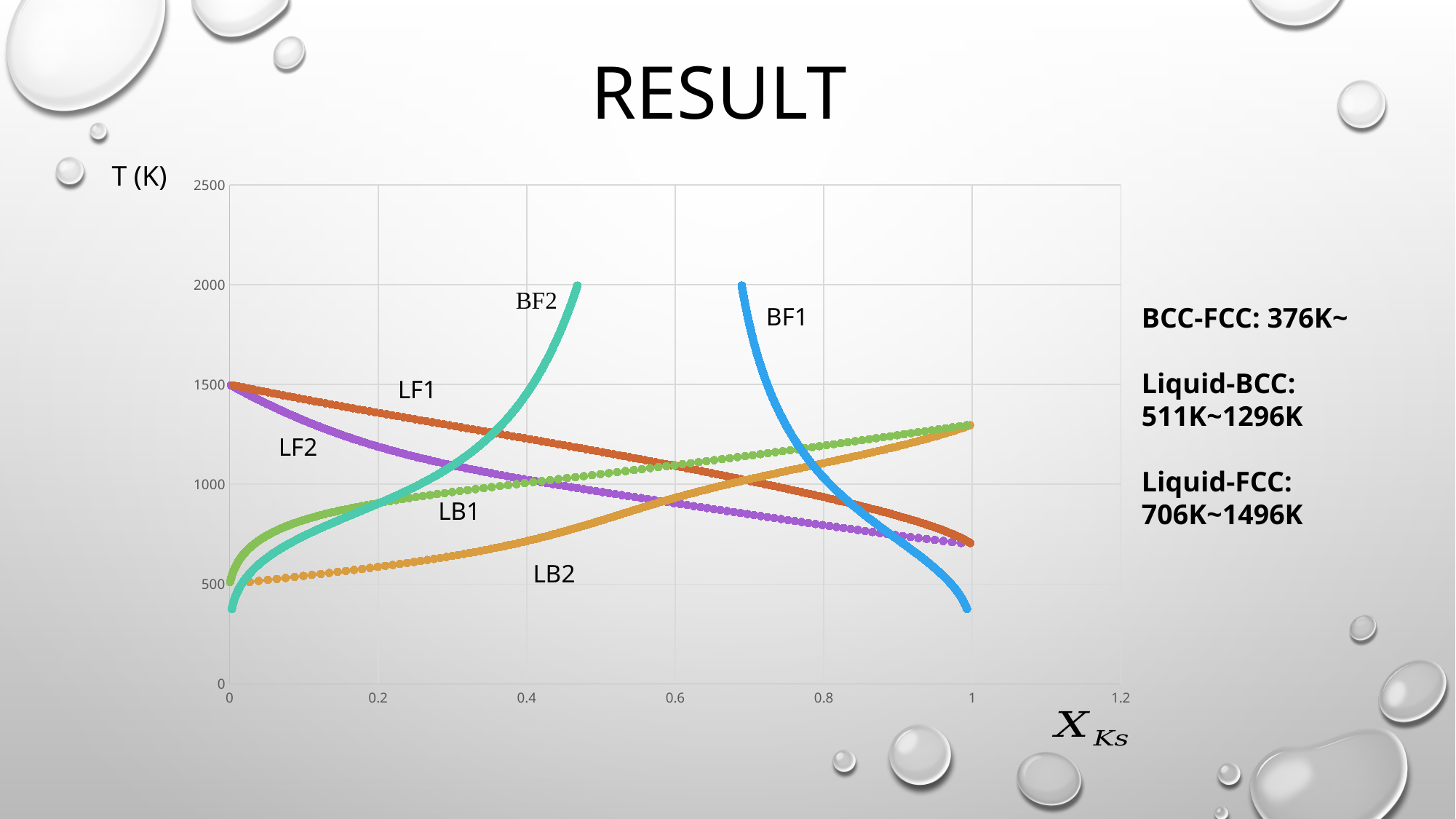
Does the LF1 curve rise or fall as X_Ks increases from 0 to 1? fall How many labelled curves are plotted on the chart? 6 Is the value of the BF2 curve at X_Ks = 0.4 greater or less than 1000? greater Is the value of the LB2 curve at X_Ks = 0.4 greater or less than 1000? less Does the LF2 curve rise or fall as X_Ks increases from 0 to 1? fall What is the highest tick value shown on the vertical axis? 2500 What kind of chart is shown on the slide? line chart Does the LB2 curve rise or fall as X_Ks increases from 0 to 1? rise At X_Ks = 0.2, which curve has the higher temperature, LF1 or LF2? LF1 Is the value of the LF1 curve at X_Ks = 0.6 greater or less than 1000? greater What is the label of the vertical axis? T (K)